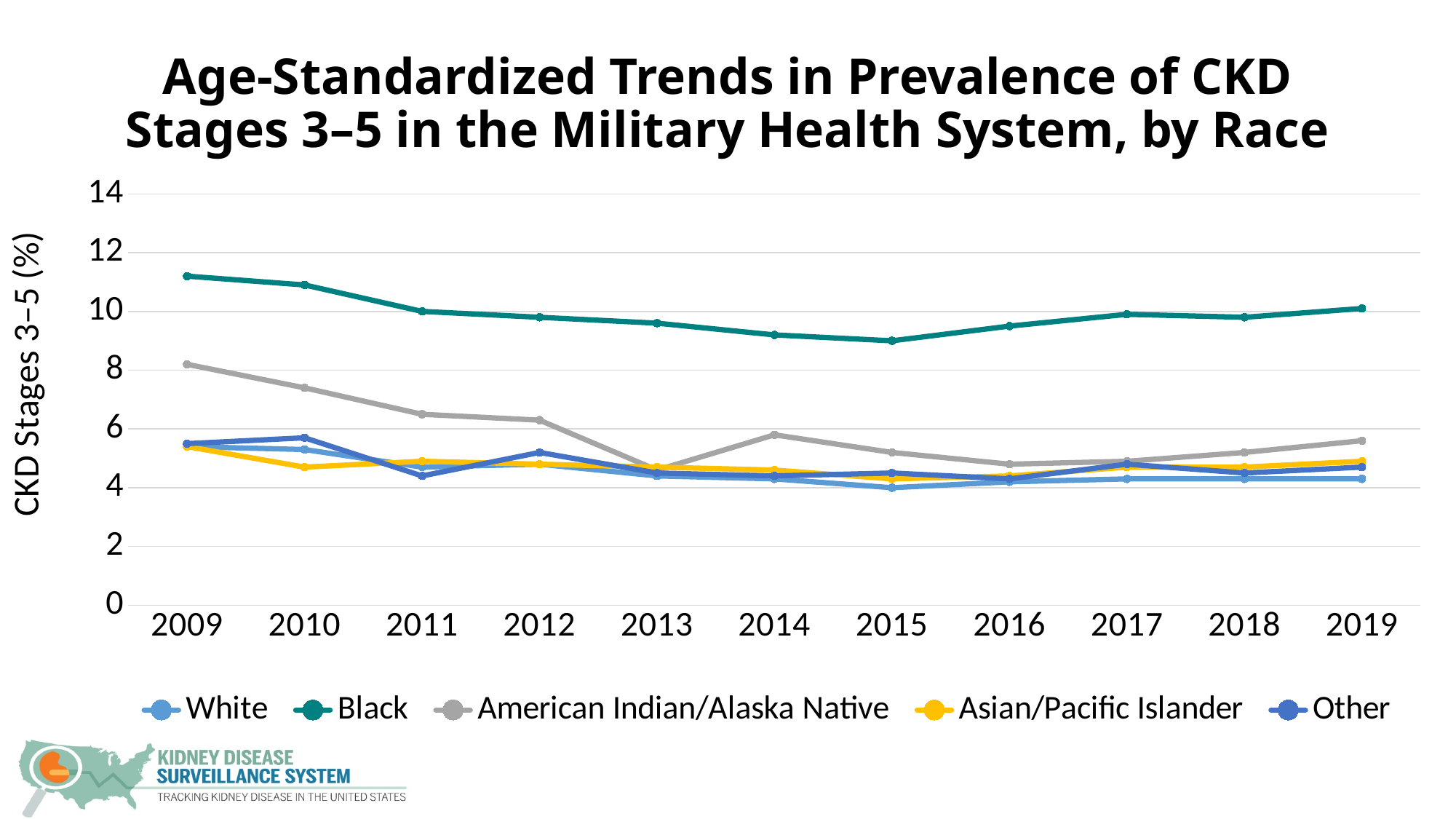
How many years are shown along the x axis? 11 Is the value for Black in 2015 greater or less than 10? less In 2012, which is larger: the value for Black or the value for American Indian/Alaska Native? Black What is the label on the y axis? CKD Stages 3–5 (%) Does the Black line rise or fall from 2009 to 2015? fall Is the value for White in 2015 greater or less than 6? less Is the value for Black in 2009 greater or less than 10? greater Which race group has the highest CKD prevalence in 2009? Black What kind of chart is shown on the slide? line chart Which race group has the highest CKD prevalence in 2019? Black How many series does the legend list? 5